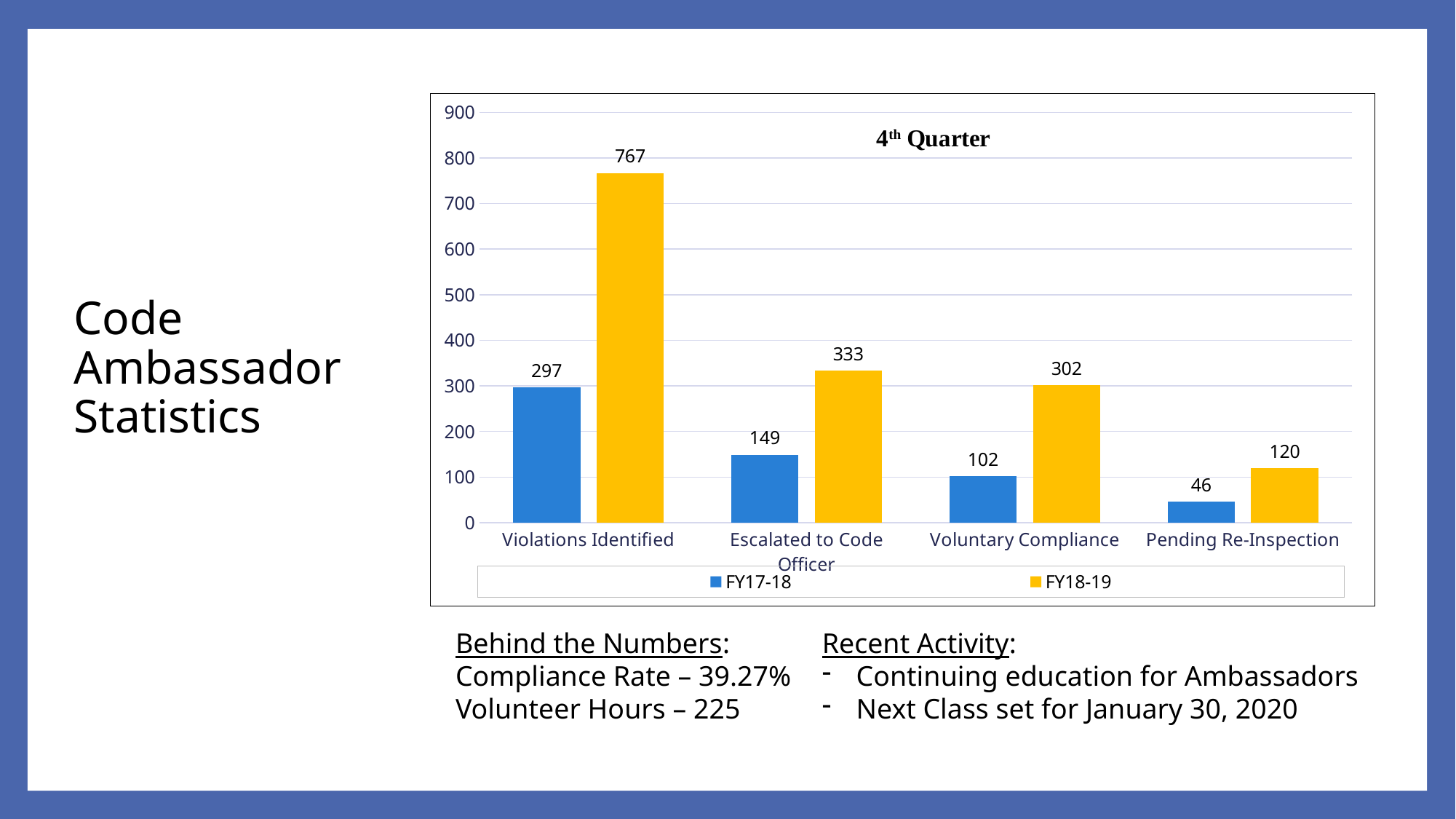
What is the FY18-19 value for Voluntary Compliance? 302 What is the difference between the FY18-19 and FY17-18 values for Voluntary Compliance? 200 How many series does the legend list? 2 What is the FY18-19 value for Violations Identified? 767 What type of chart is shown? Bar chart Which category has the highest FY18-19 value? Violations Identified What is the FY17-18 value for Escalated to Code Officer? 149 What is the FY17-18 value for Pending Re-Inspection? 46 What is the difference between the FY18-19 and FY17-18 values for Violations Identified? 470 How many categories are shown on the x axis? 4 Which is larger: the FY17-18 value for Violations Identified or the FY18-19 value for Escalated to Code Officer? FY18-19 value for Escalated to Code Officer Which category has the lowest FY17-18 value? Pending Re-Inspection